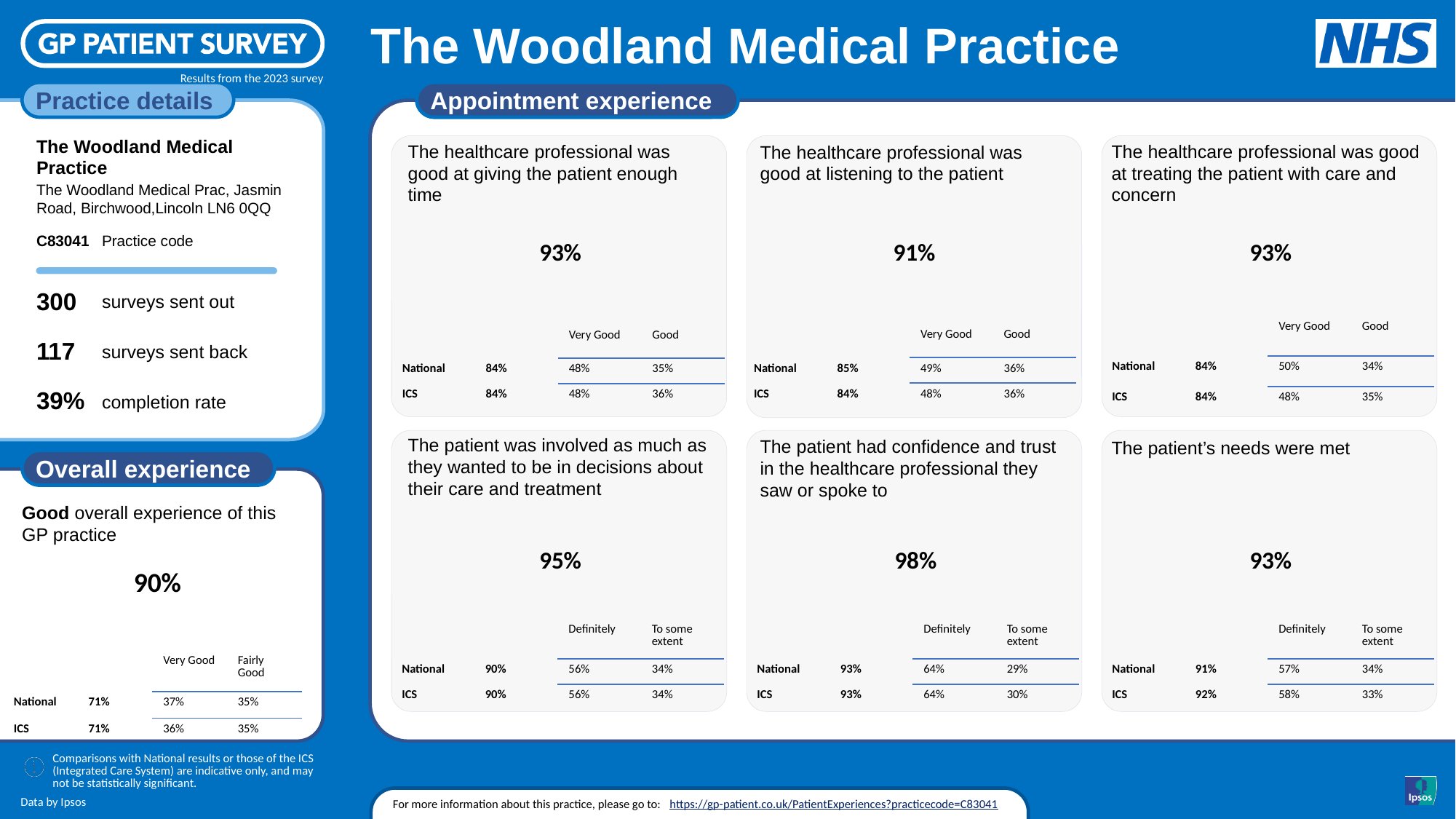
In the 'The patient had confidence and trust in the healthcare professional' chart, what is the difference between the practice result (98%) and the National result (93%)? 5 percentage points In the 'Overall experience' chart, what is the National 'Very Good' percentage? 37% In the 'The patient's needs were met' chart, which is higher: the National result or the ICS result? ICS How many measures are shown in the 'Appointment experience' section? 6 In the 'Overall experience' chart, what percentage of patients reported a good overall experience of this GP practice? 90% In the 'Appointment experience' section, which measure has the highest practice result? The patient had confidence and trust in the healthcare professional they saw or spoke to In the 'Appointment experience' section, what is the practice's result for 'The patient had confidence and trust in the healthcare professional they saw or spoke to'? 98% In the 'Appointment experience' section, what is the practice's result for 'The healthcare professional was good at listening to the patient'? 91% In the 'Appointment experience' section, which measure has the lowest practice result? The healthcare professional was good at listening to the patient In the 'Overall experience' chart, what is the National result for good overall experience? 71% In the 'The patient was involved as much as they wanted to be in decisions about their care and treatment' chart, what are the two response categories shown in the breakdown? Definitely and To some extent In the 'The healthcare professional was good at treating the patient with care and concern' chart, what is the ICS 'Very Good' percentage? 48%